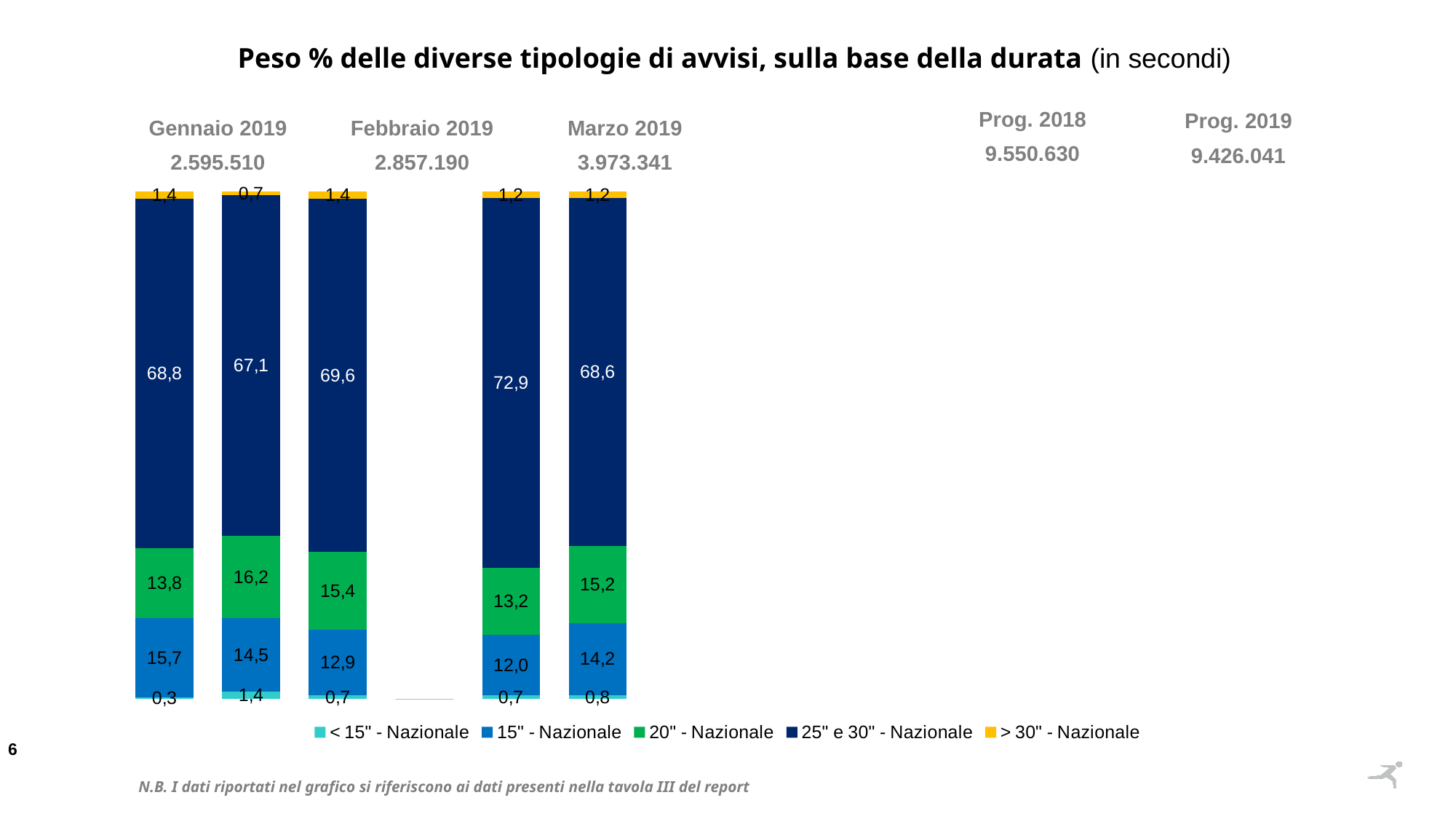
What is the title of the chart? Peso % delle diverse tipologie di avvisi, sulla base della durata (in secondi) Is the 20" - Nazionale value larger in the third bar from the left or in the fifth bar from the left? the third bar (15,4) What is the total of all segments in the first bar from the left? 100,0 Which bar from the left has the highest value for the 25" e 30" - Nazionale segment? the fourth bar (72,9) What is the value of the 25" e 30" - Nazionale segment in the first bar from the left? 68,8 What kind of chart is shown on the slide? stacked bar chart How many bars are plotted in the chart? 5 How many series does the legend list? 5 What is the difference between the 15" - Nazionale values of the first and second bars from the left? 1,2 What is the value of the > 30" - Nazionale segment in the first bar from the left? 1,4 What is the value of the 20" - Nazionale segment in the second bar from the left? 16,2 Which bar from the left has the lowest value for the < 15" - Nazionale segment? the first bar (0,3)